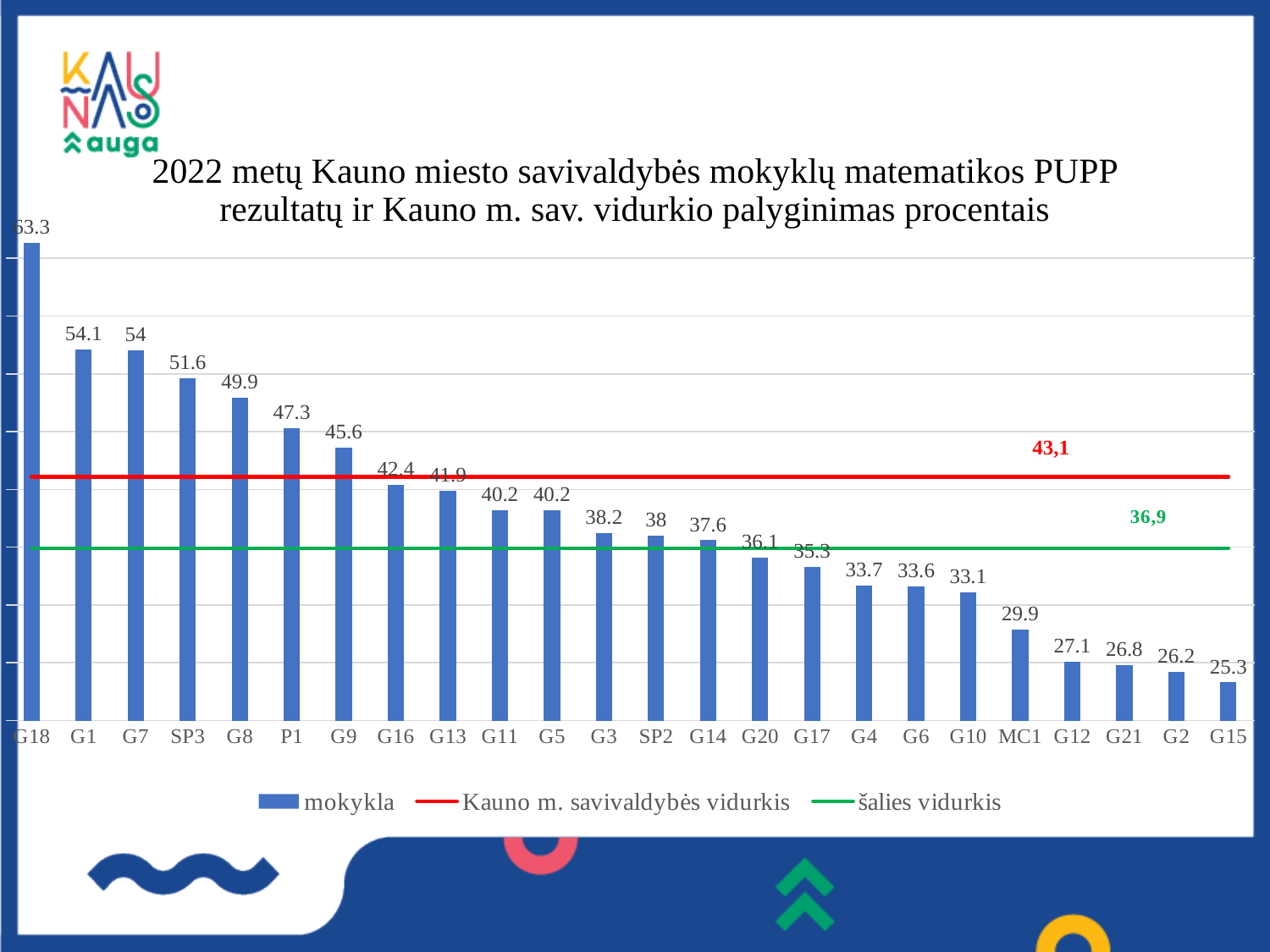
Which is larger, the value for G9 or the value for G16? G9 What is the difference between the values for G7 and G8? 4.1 What is the value for G1? 54.1 What kind of chart is this? combination bar and line chart How many schools are shown on the x axis? 24 What value is shown for the šalies vidurkis line? 36,9 Which school has the highest value? G18 What is the value for MC1? 29.9 What value is shown for the Kauno m. savivaldybės vidurkis line? 43,1 Which school has the lowest value? G15 What is the value for SP3? 51.6 How many entries does the legend list? 3